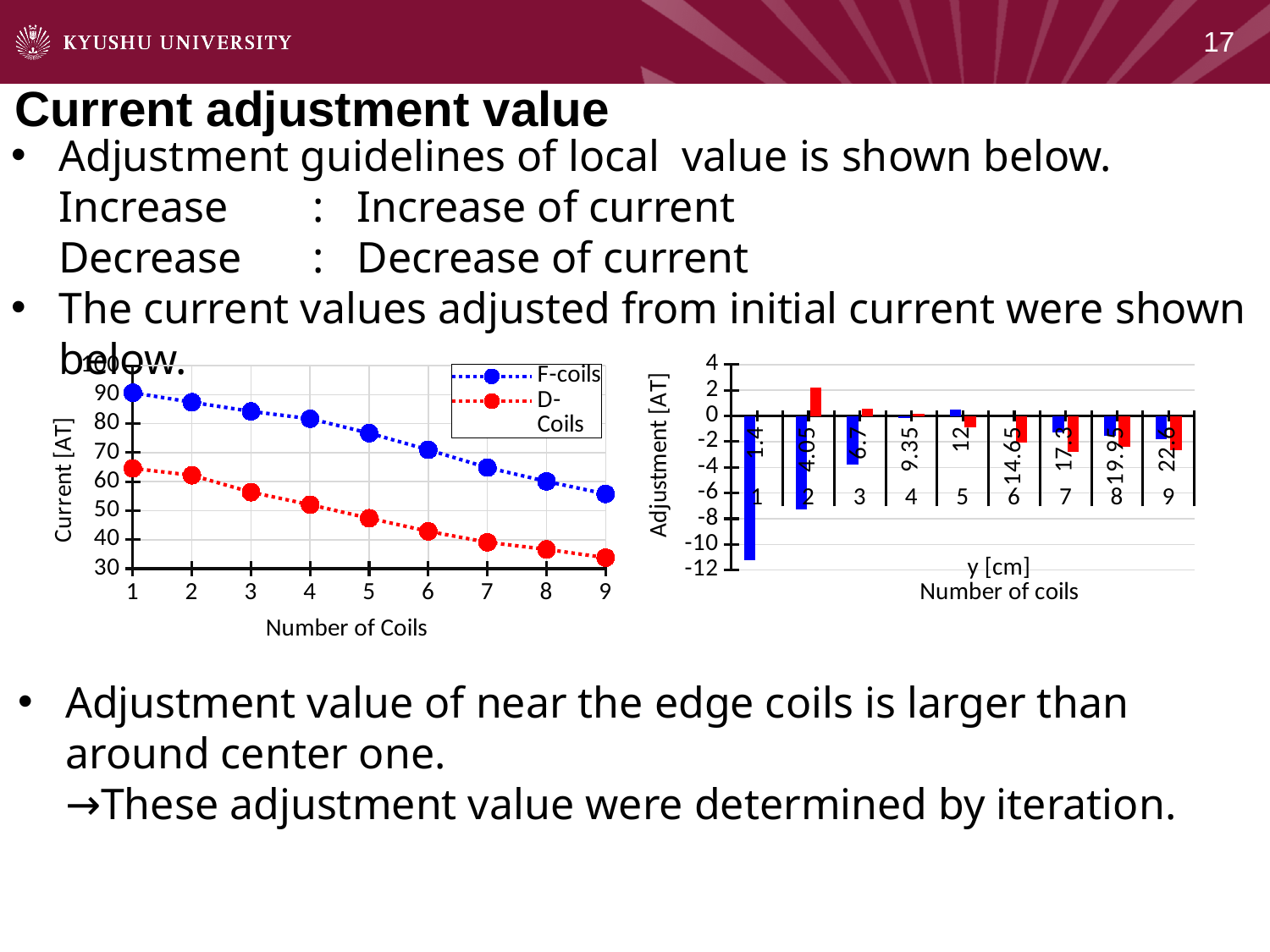
In the left chart, do the F-coils current values rise or fall as the number of coils increases from 1 to 9? fall How many coil numbers are shown on the x axis of the right chart? 9 How many series does the legend of the left chart list? 2 In the right chart, is the value of the blue bar for coil number 1 greater or less than -8? less What are the two series named in the legend of the left chart? F-coils and D-Coils In the left chart, which series has the larger current at coil number 5, F-coils or D-Coils? F-coils What kind of chart is the right chart showing Adjustment [AT]? bar chart How many data points does the F-coils series have in the left chart? 9 In the left chart, is the D-Coils current at coil number 9 greater or less than 40? less What kind of chart is the left chart showing Current [AT] against Number of Coils? line chart In the left chart, is the F-coils current at coil number 1 greater or less than 80? greater